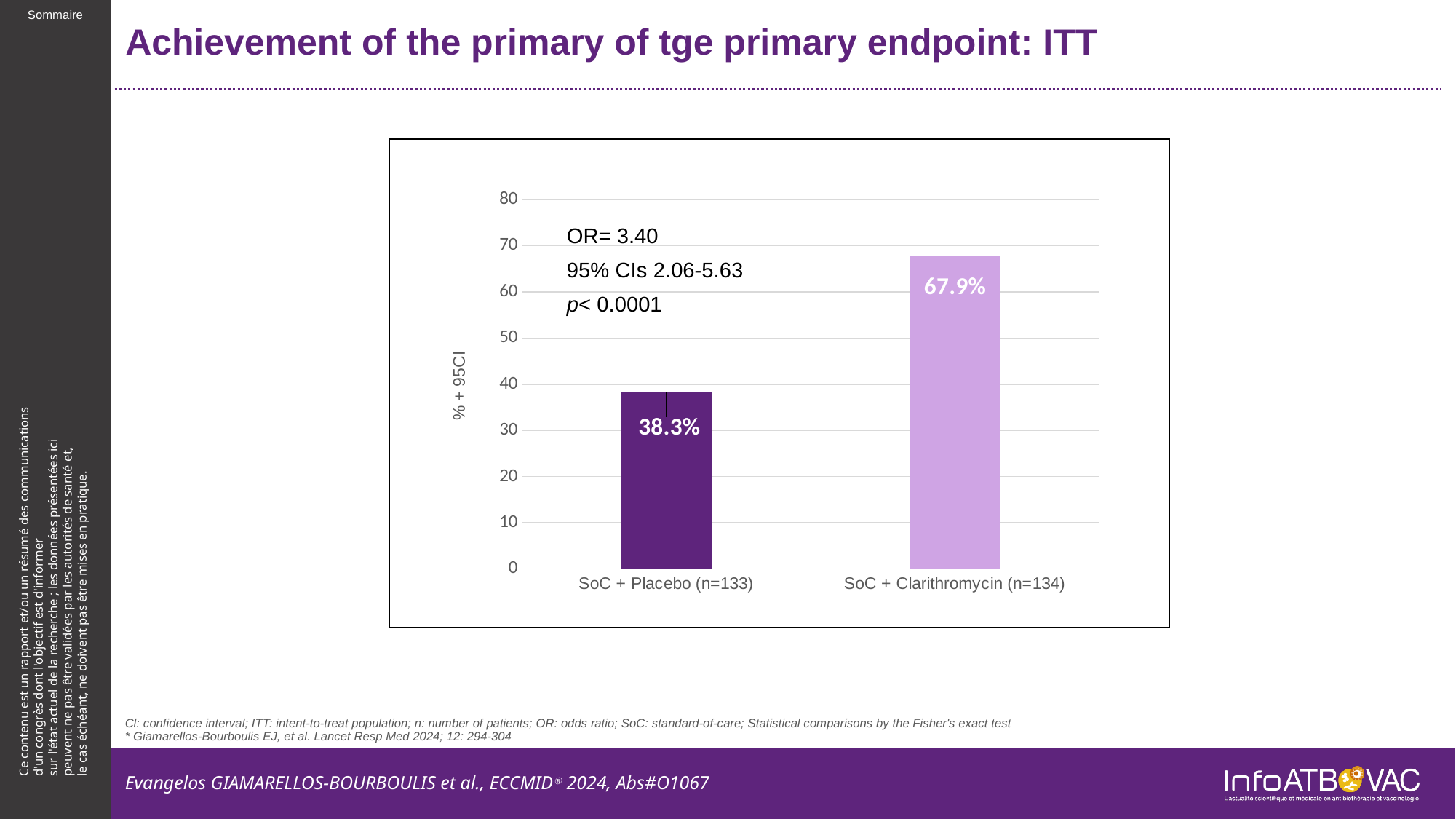
What is the value for SoC + Placebo (n=133)? 38.3% What odds ratio (OR) is printed on the chart? OR= 3.40 Which category has the highest value? SoC + Clarithromycin (n=134) What kind of chart is shown on the slide? Bar chart What is the difference between the values for SoC + Clarithromycin (n=134) and SoC + Placebo (n=133)? 29.6% Is the value for SoC + Clarithromycin (n=134) greater or less than 60? greater How many categories are shown on the x axis? 2 Is the value for SoC + Placebo (n=133) greater or less than 40? less Which is larger, the value for SoC + Placebo (n=133) or SoC + Clarithromycin (n=134)? SoC + Clarithromycin (n=134) What is the label of the y axis? % + 95CI Which category has the lowest value? SoC + Placebo (n=133) What is the value for SoC + Clarithromycin (n=134)? 67.9%